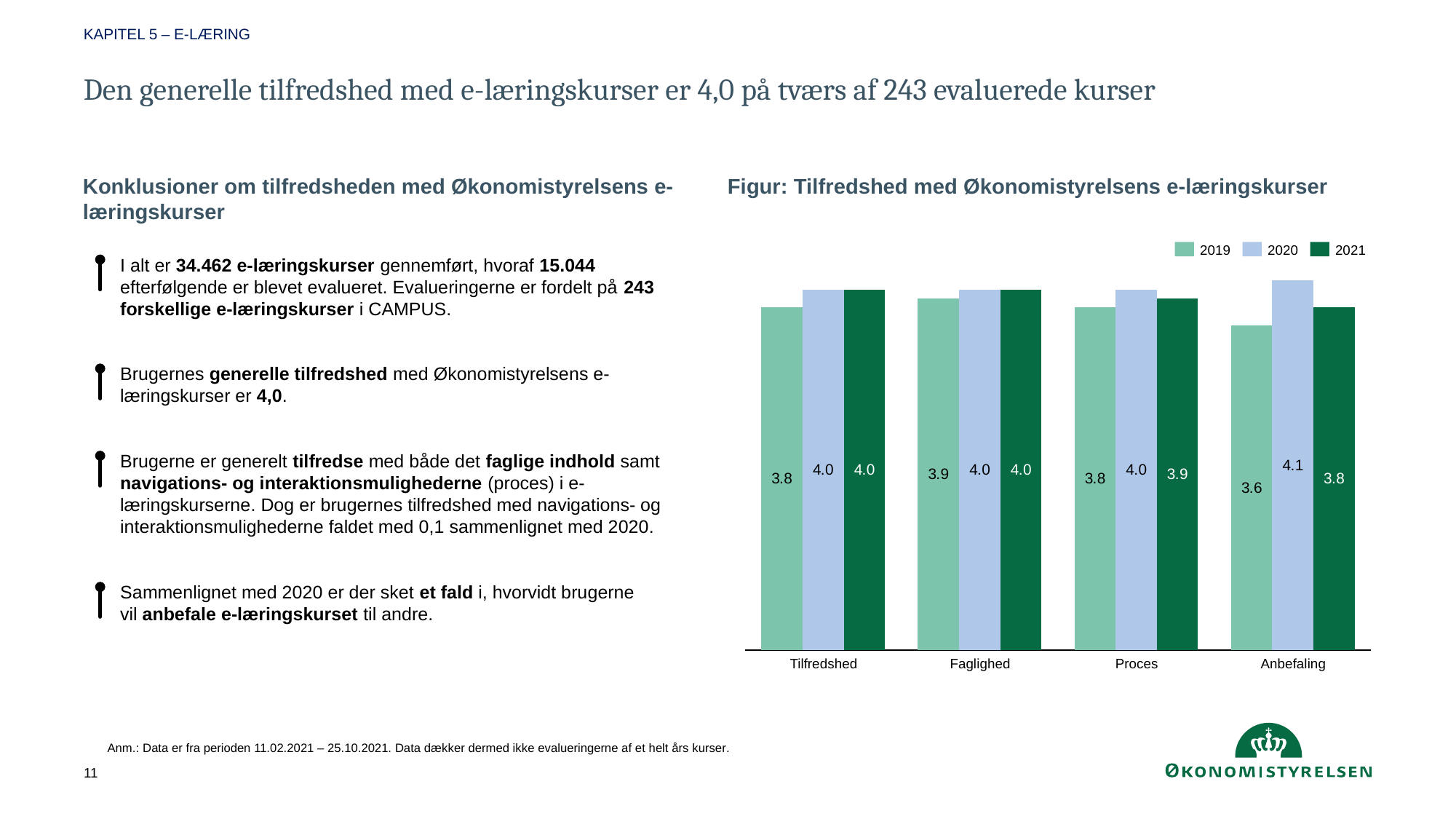
How many series does the legend list? 3 What is the value for Anbefaling in 2020? 4.1 How many categories are shown on the x axis? 4 Which category has the highest value in 2020? Anbefaling Which is larger for Proces: the 2020 value or the 2021 value? 2020 What is the title of the chart? Figur: Tilfredshed med Økonomistyrelsens e-læringskurser What is the difference between the 2020 and 2021 values for Anbefaling? 0.3 Which category has the lowest value in 2019? Anbefaling What is the value for Faglighed in 2019? 3.9 What kind of chart is shown on the slide? Bar chart What is the value for Tilfredshed in 2019? 3.8 What is the value for Proces in 2021? 3.9